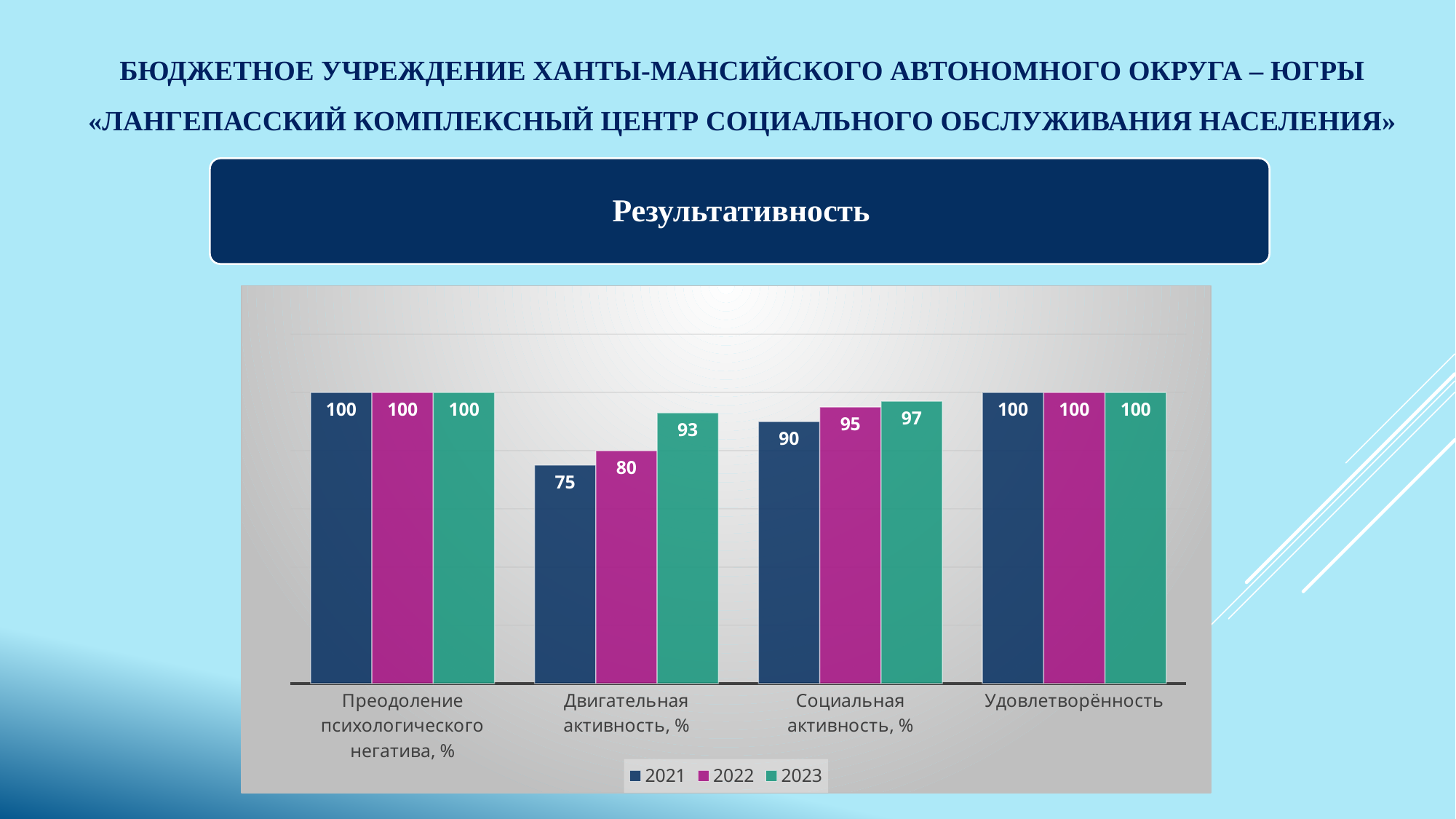
What is the value for 2021 in the category Двигательная активность, %? 75 How many categories are shown on the x axis? 4 Which category has the lowest value for the 2021 series? Двигательная активность, % How many series does the legend list? 3 What kind of chart is shown on the slide? bar chart What is the value for 2023 in the category Социальная активность, %? 97 Do the values for Социальная активность, % rise or fall from 2021 to 2023? rise What is the difference between the 2022 and 2021 values for Социальная активность, %? 5 What is the difference between the 2023 and 2021 values for Двигательная активность, %? 18 Which is larger: the 2023 value for Двигательная активность, % or the 2023 value for Социальная активность, %? Социальная активность, % What is the value for 2022 in the category Двигательная активность, %? 80 What is the value for 2021 in the category Удовлетворённость? 100